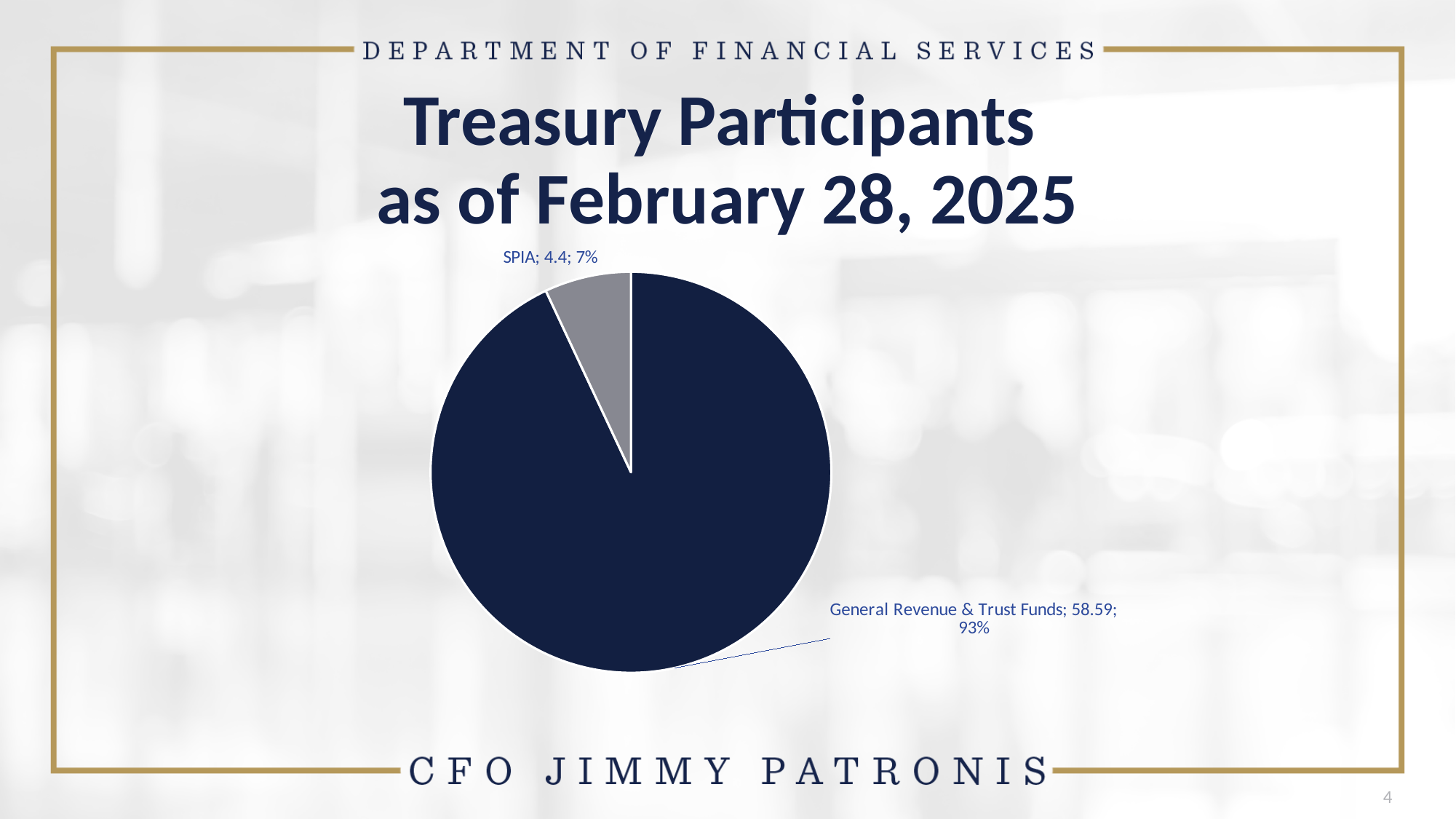
What is the total of the two slice values? 62.99 What kind of chart is shown on the slide? pie chart Which is larger, the value for SPIA or the value for General Revenue & Trust Funds? General Revenue & Trust Funds How many slices does the pie chart have? 2 What is the difference between the values for General Revenue & Trust Funds and SPIA? 54.19 What share of the pie does SPIA represent? 7% Which category has the largest slice? General Revenue & Trust Funds What is the value for General Revenue & Trust Funds? 58.59 What is the title of the slide containing the chart? Treasury Participants as of February 28, 2025 What share of the pie does General Revenue & Trust Funds represent? 93% What is the value for SPIA? 4.4 Which category has the smallest slice? SPIA